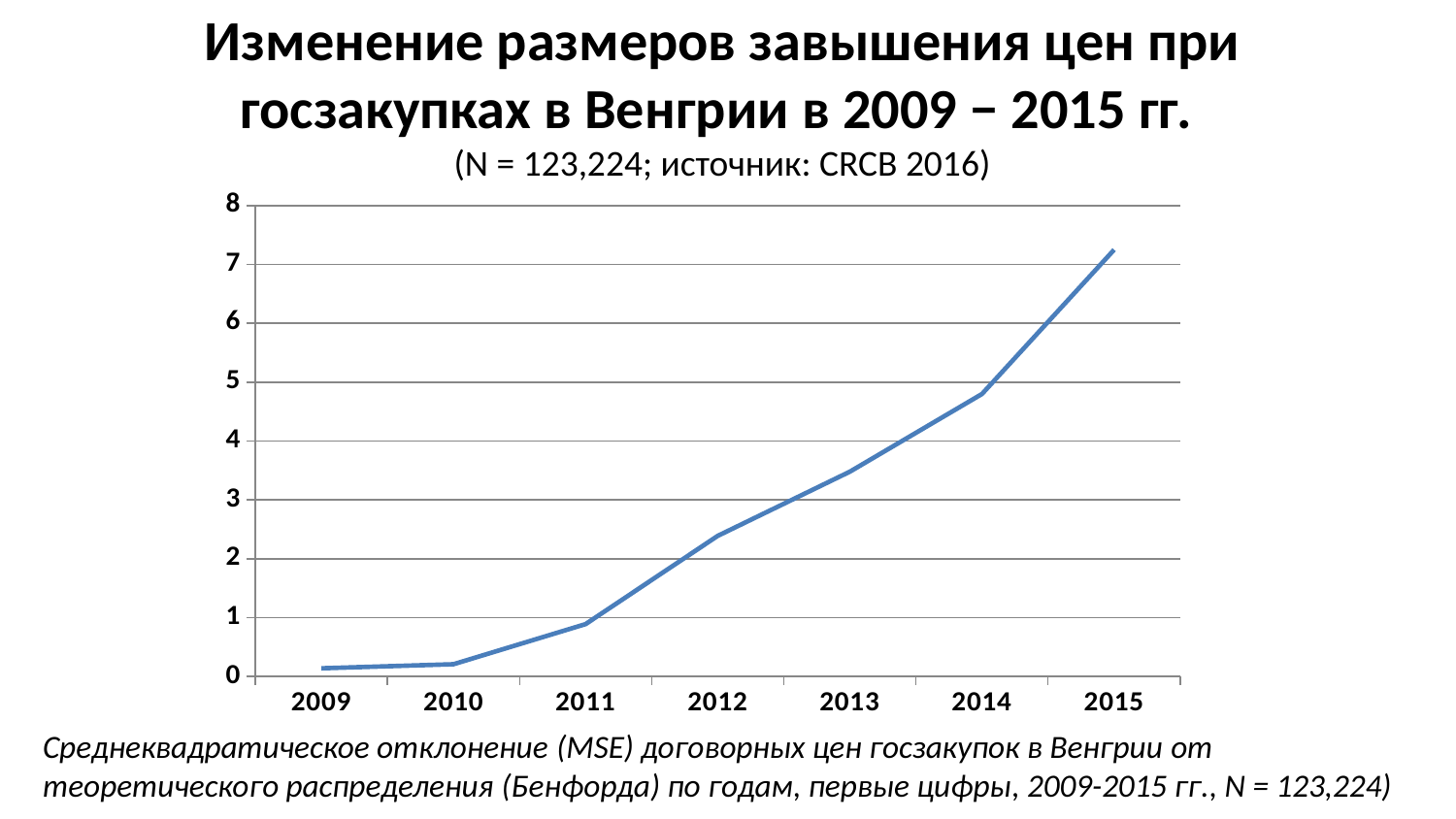
Is the value for 2015 greater or less than 7? greater Which is larger, the value for 2013 or the value for 2014? 2014 Is the value for 2011 greater or less than 1? less Do the values rise or fall from 2009 to 2015? rise Is the value for 2014 greater or less than 5? less What is the maximum value shown on the y axis? 8 What sample size N is given in the chart subtitle? 123,224 What kind of chart is shown on the slide? line chart Which year has the highest value on the chart? 2015 How many years are plotted along the x axis? 7